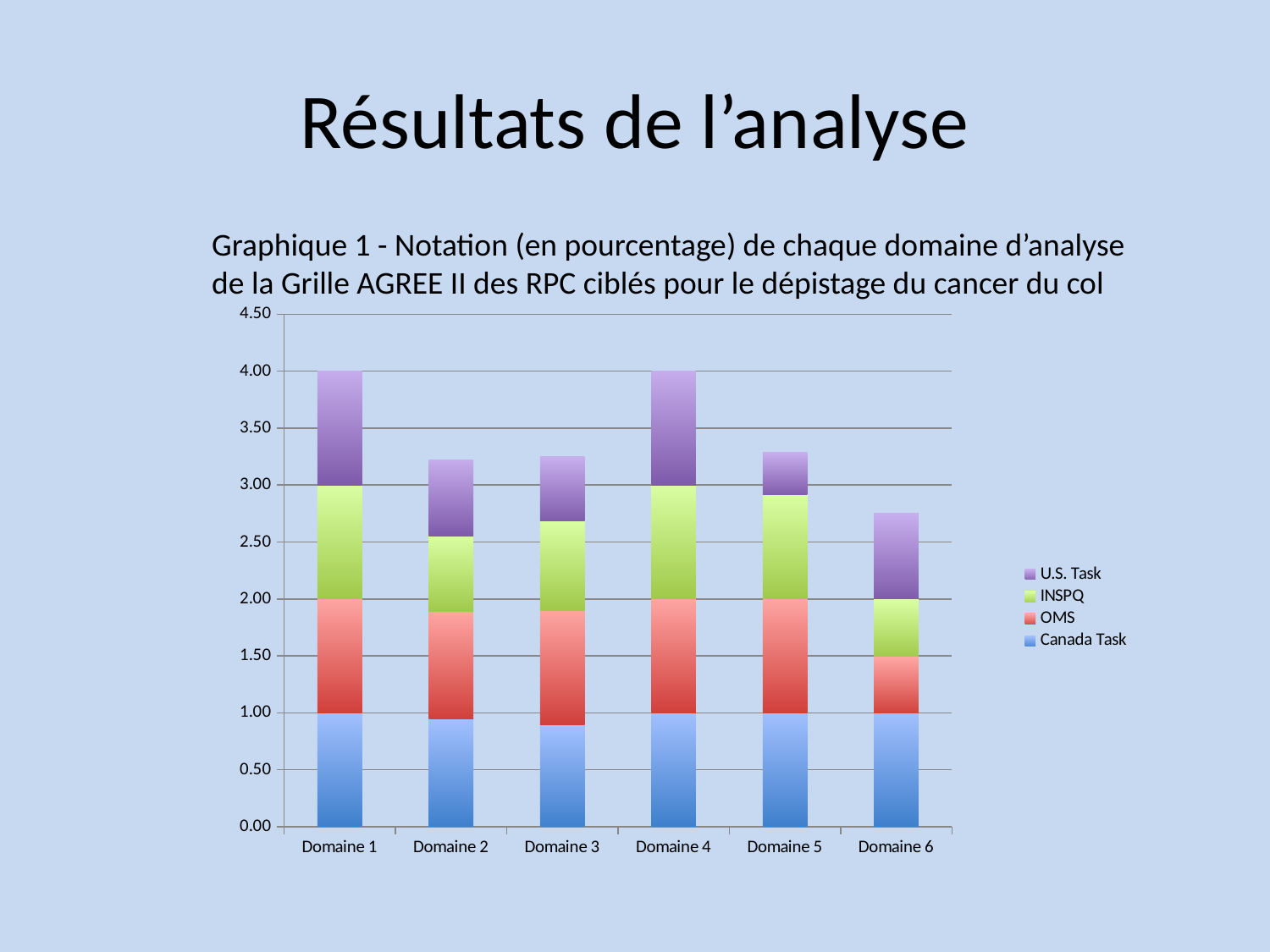
Is the total for Domaine 2 greater or less than 3.00? greater Which series are listed in the legend? U.S. Task, INSPQ, OMS, Canada Task What is the value of the Canada Task segment for Domaine 1? 1.00 Which has a larger total, Domaine 1 or Domaine 6? Domaine 1 How many series does the legend list? 4 How many domains (categories) are shown on the x axis? 6 Which domain has the lowest total stacked bar? Domaine 6 What kind of chart is shown on the slide? Stacked bar chart Is the total for Domaine 5 greater or less than 3.50? less What is the total height of the stacked bar for Domaine 1? 4.00 What is the total height of the stacked bar for Domaine 4? 4.00 Is the total for Domaine 6 greater or less than 3.00? less